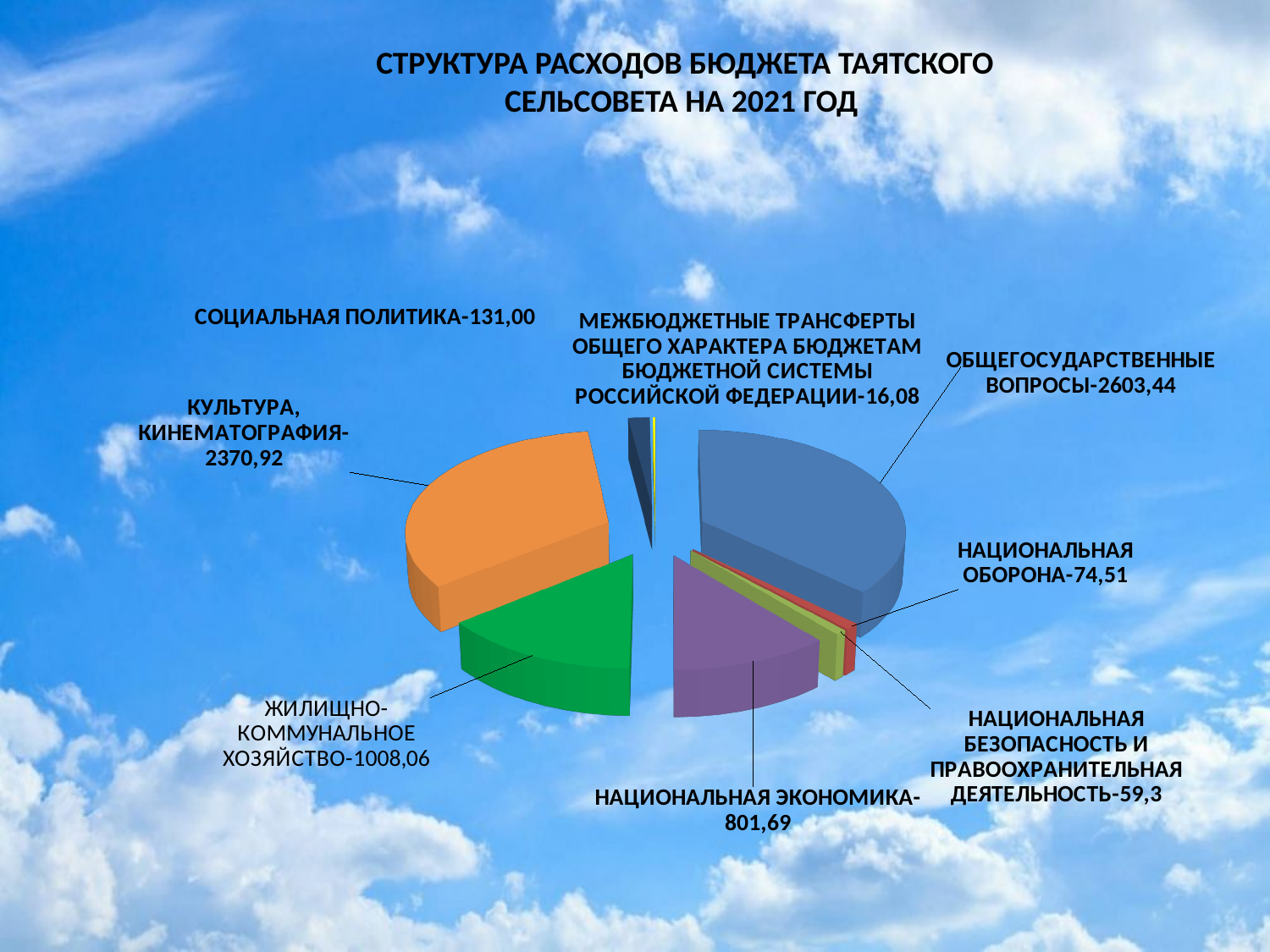
What type of chart is shown on the slide? Pie chart Which is larger, СОЦИАЛЬНАЯ ПОЛИТИКА or НАЦИОНАЛЬНАЯ ОБОРОНА? СОЦИАЛЬНАЯ ПОЛИТИКА What is the value for ЖИЛИЩНО-КОММУНАЛЬНОЕ ХОЗЯЙСТВО? 1008,06 Which category has the largest value? ОБЩЕГОСУДАРСТВЕННЫЕ ВОПРОСЫ What is the value for НАЦИОНАЛЬНАЯ ОБОРОНА? 74,51 How many categories does the pie chart show? 8 What is the difference between ЖИЛИЩНО-КОММУНАЛЬНОЕ ХОЗЯЙСТВО and НАЦИОНАЛЬНАЯ ЭКОНОМИКА? 206,37 What is the value for КУЛЬТУРА, КИНЕМАТОГРАФИЯ? 2370,92 What is the difference between ОБЩЕГОСУДАРСТВЕННЫЕ ВОПРОСЫ and КУЛЬТУРА, КИНЕМАТОГРАФИЯ? 232,52 What is the value for МЕЖБЮДЖЕТНЫЕ ТРАНСФЕРТЫ ОБЩЕГО ХАРАКТЕРА БЮДЖЕТАМ БЮДЖЕТНОЙ СИСТЕМЫ РОССИЙСКОЙ ФЕДЕРАЦИИ? 16,08 What is the value for ОБЩЕГОСУДАРСТВЕННЫЕ ВОПРОСЫ? 2603,44 Which category has the smallest value? МЕЖБЮДЖЕТНЫЕ ТРАНСФЕРТЫ ОБЩЕГО ХАРАКТЕРА БЮДЖЕТАМ БЮДЖЕТНОЙ СИСТЕМЫ РОССИЙСКОЙ ФЕДЕРАЦИИ